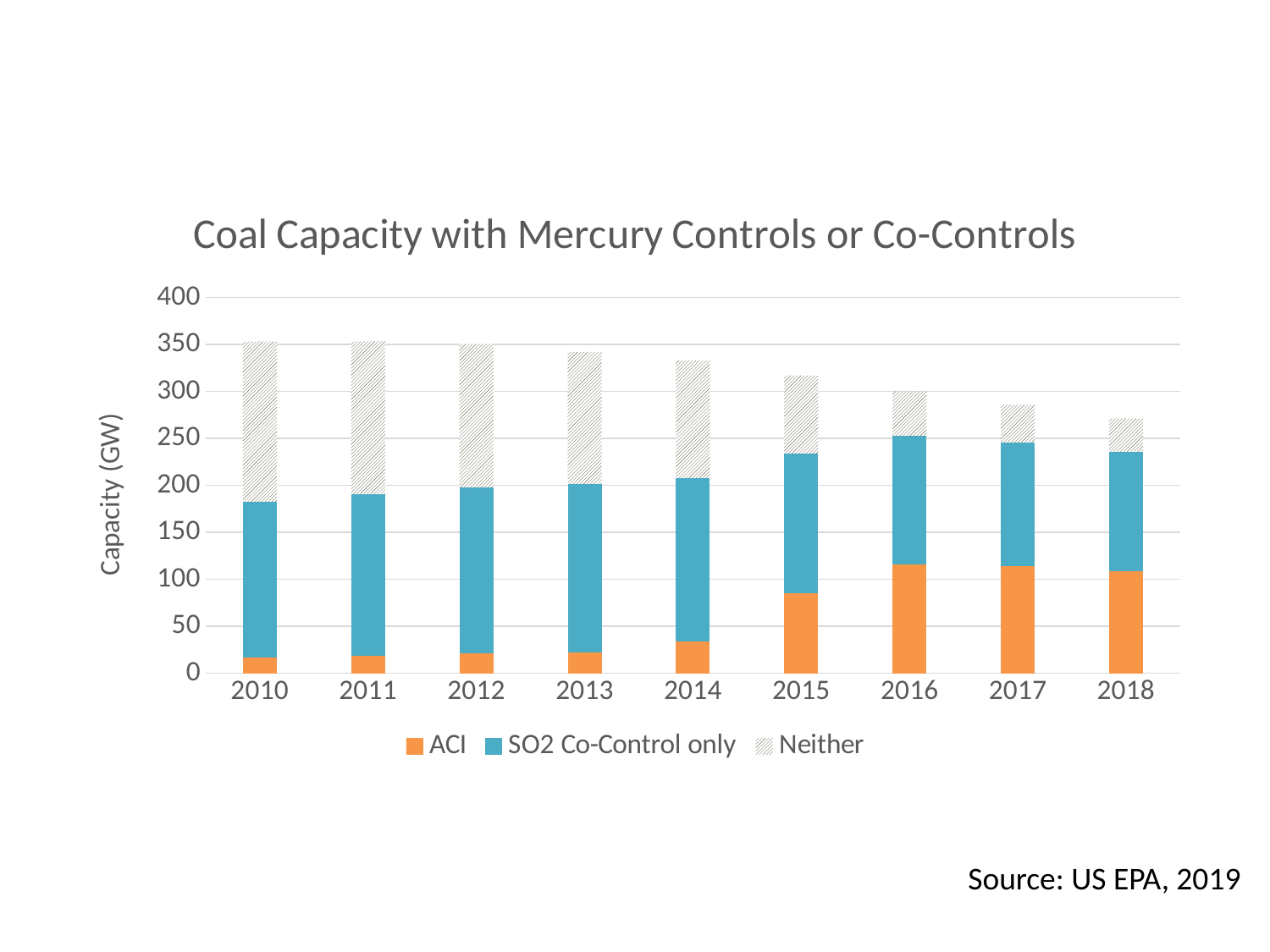
Is the total stacked bar for 2010 greater or less than 300? greater Which year has the larger ACI value, 2014 or 2015? 2015 Which year has the lowest total stacked bar? 2018 Is the ACI value for 2010 greater or less than 50? less Does the total height of the stacked bars rise or fall from 2010 to 2018? Fall What kind of chart is shown on the slide? Stacked bar chart What is the title of the chart? Coal Capacity with Mercury Controls or Co-Controls How many years are shown on the x axis of the chart? 9 How many series does the legend list? 3 Is the total stacked bar for 2018 greater or less than 300? less What is the label on the y axis of the chart? Capacity (GW)